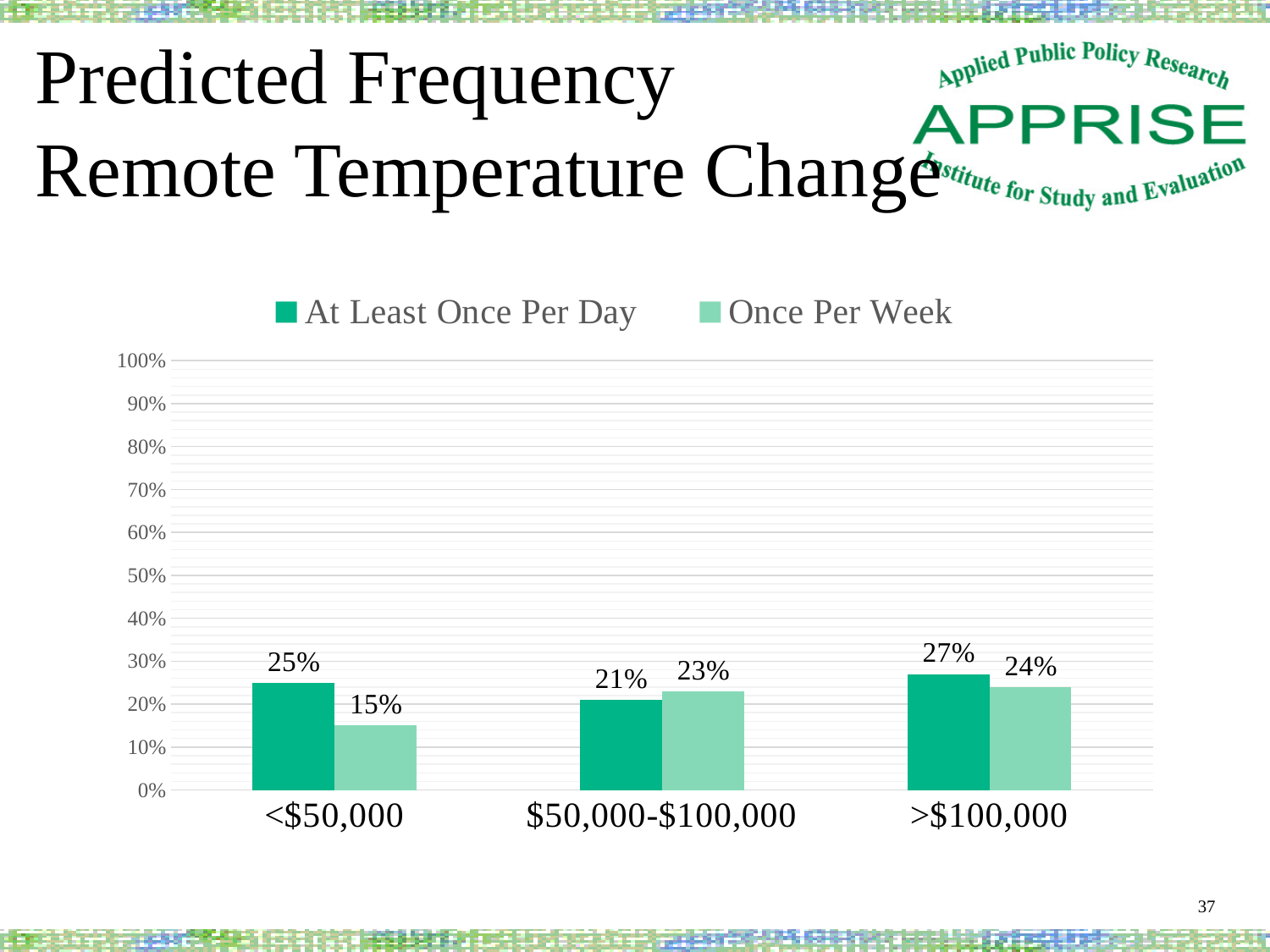
What is the value for At Least Once Per Day in the <$50,000 category? 25% What is the value for Once Per Week in the $50,000-$100,000 category? 23% What kind of chart is shown on the slide? bar chart How many series does the legend list? 2 Is the value for Once Per Week in the <$50,000 category greater or less than 20%? less What is the value for Once Per Week in the >$100,000 category? 24% In the $50,000-$100,000 category, which is larger: At Least Once Per Day or Once Per Week? Once Per Week Which income category has the lowest value for Once Per Week? <$50,000 Which income category has the highest value for At Least Once Per Day? >$100,000 What is the difference between At Least Once Per Day and Once Per Week in the <$50,000 category? 10% What is the maximum value shown on the y axis? 100% How many income categories are shown on the x axis? 3